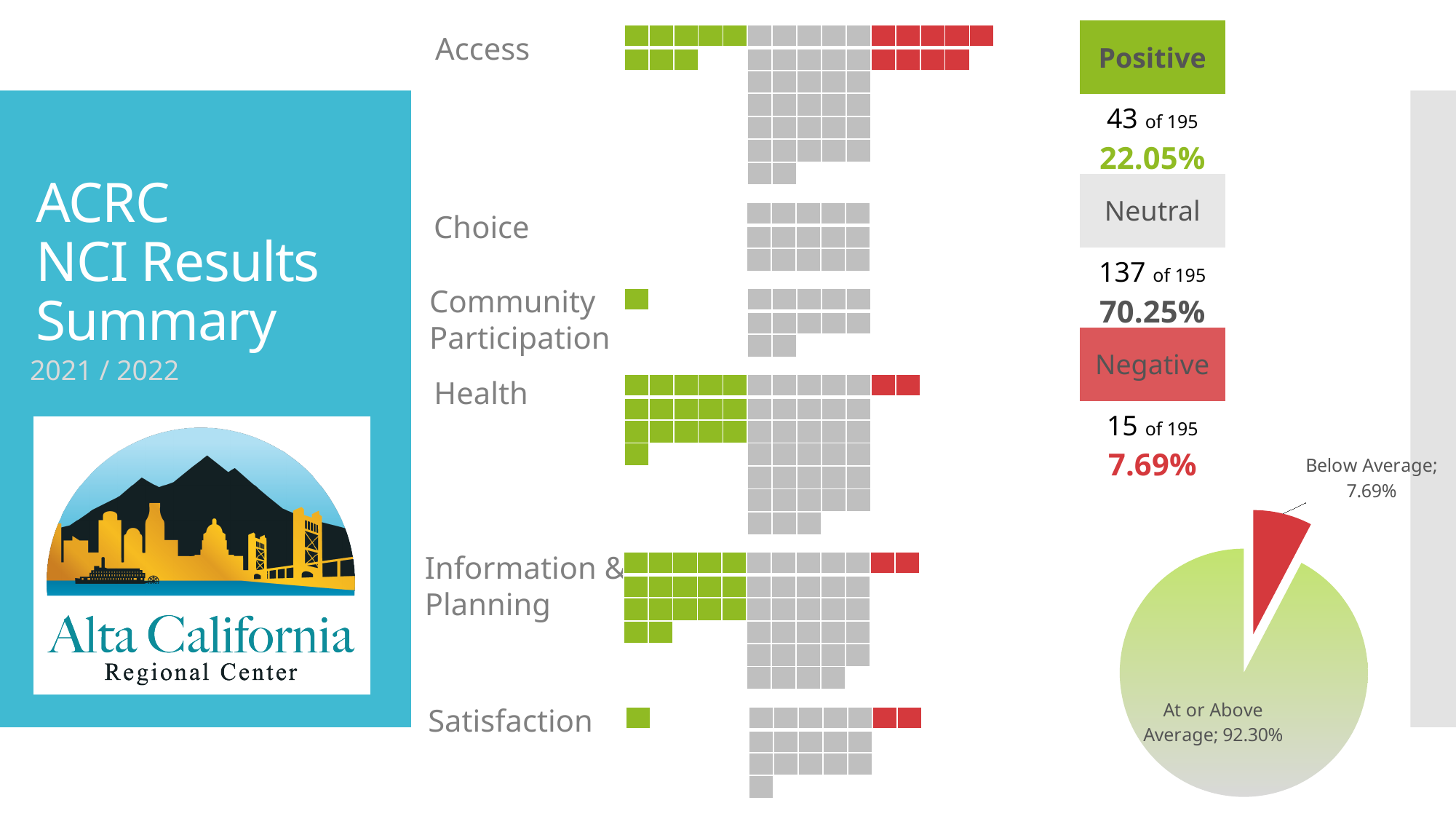
In the Positive/Neutral/Negative summary, which category has the highest count? Neutral In the Positive/Neutral/Negative summary, how many more Neutral responses are there than Positive responses? 94 In the pie chart, which slice is larger, 'At or Above Average' or 'Below Average'? At or Above Average How many categories are listed in the square-grid chart on the left (Access, Choice, etc.)? 6 In the pie chart, what share is labelled 'At or Above Average'? 92.30% How many slices does the pie chart have? 2 What kind of chart is shown in the bottom right of the slide? Pie chart In the Positive/Neutral/Negative summary, what percentage is Neutral? 70.25% In the Positive/Neutral/Negative summary, how many responses are Positive? 43 of 195 In the Positive/Neutral/Negative summary, how many responses are Negative? 15 of 195 In the square-grid chart, how many red (Negative) squares does the Satisfaction row have? 2 In the pie chart, what share is labelled 'Below Average'? 7.69%